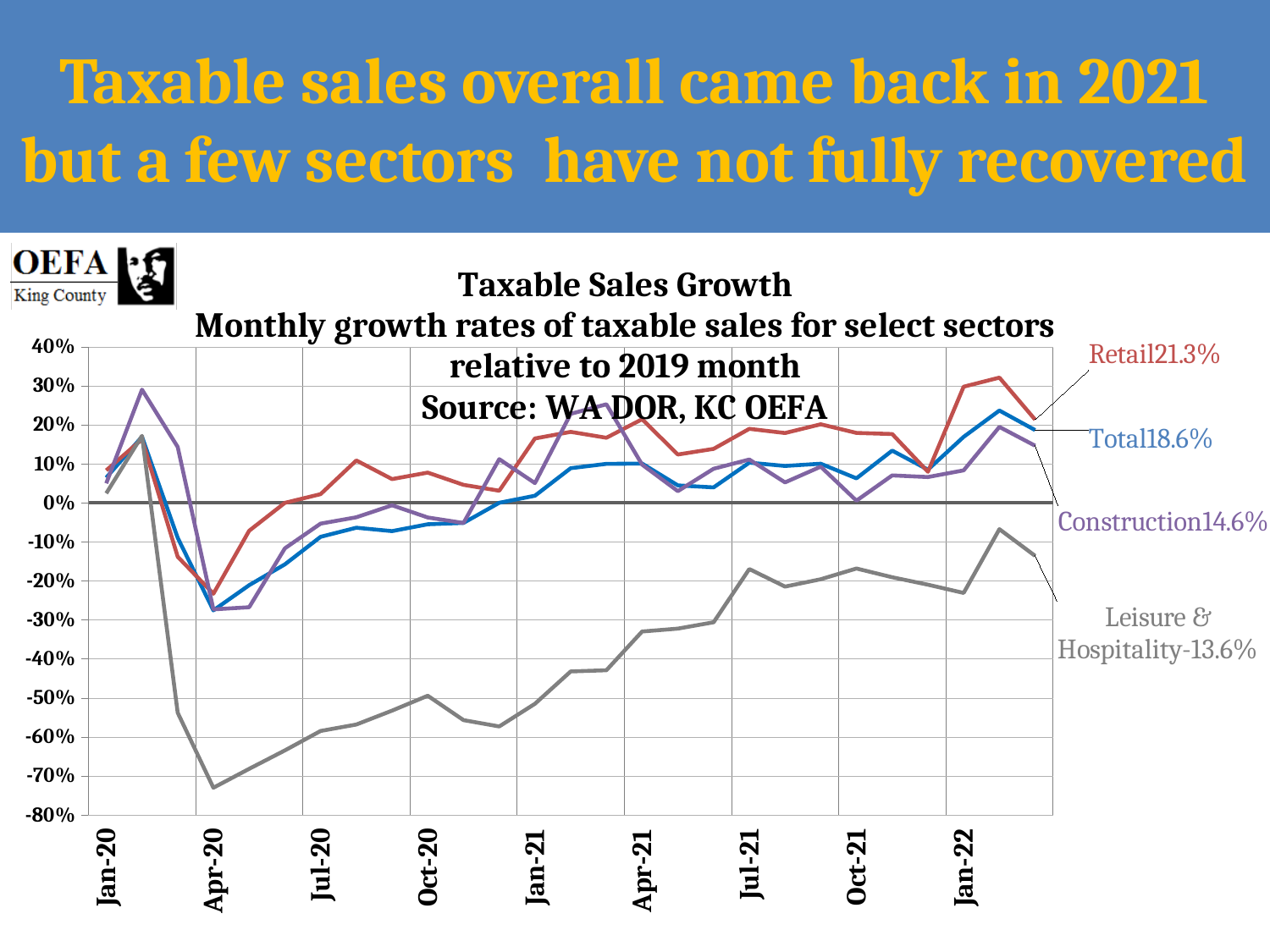
What is the source cited in the chart title? WA DOR, KC OEFA What kind of chart is shown on the slide? Line chart What is the difference between the labelled end values for Retail and Total? 2.7 percentage points Which has the larger labelled end value, Total or Construction? Total Which series has the highest labelled end value? Retail How many series are plotted on the chart? 4 What is the final labelled value for the Leisure & Hospitality series? -13.6% Is the value for Leisure & Hospitality at Apr-20 greater or less than -70%? less What is the final labelled value for the Construction series? 14.6% What is the final labelled value for the Retail series? 21.3% What is the final labelled value for the Total series? 18.6% Which series has the lowest labelled end value? Leisure & Hospitality